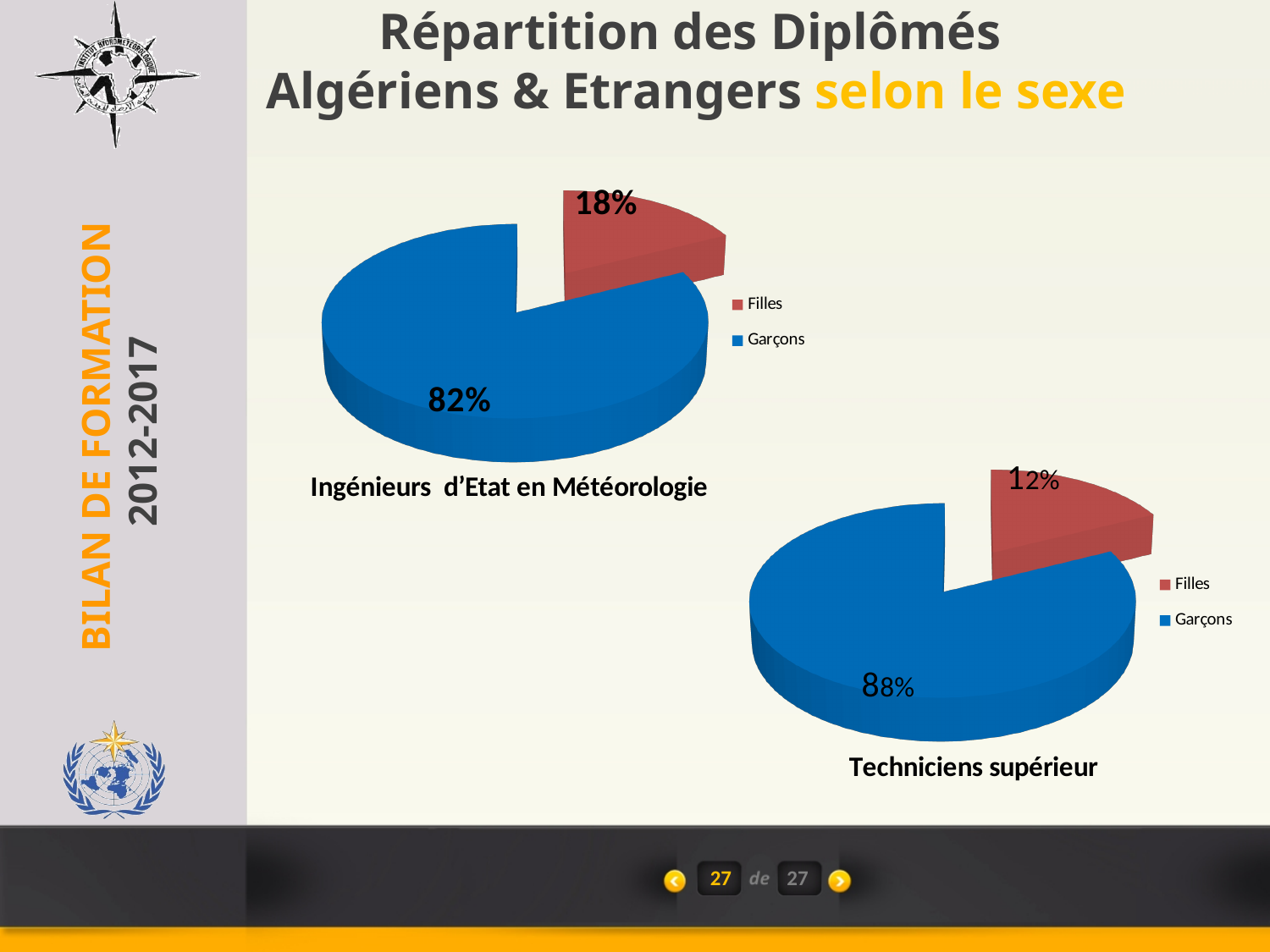
In the 'Techniciens supérieur' chart, what colour is the Garçons slice? Blue In the 'Techniciens supérieur' chart, what share of the pie is Garçons? 88% In the 'Techniciens supérieur' chart, what is the difference between the Garçons and Filles shares? 76% What kind of chart is the 'Techniciens supérieur' chart? Pie chart In the 'Techniciens supérieur' chart, which category has the smallest slice? Filles In the 'Techniciens supérieur' chart, what share of the pie is Filles? 12% In the 'Ingénieurs d'Etat en Météorologie' chart, which category has the largest slice? Garçons How many categories does the legend of the 'Ingénieurs d'Etat en Météorologie' chart list? 2 In the 'Ingénieurs d'Etat en Météorologie' chart, what is the difference between the Garçons and Filles shares? 64% In the 'Ingénieurs d'Etat en Météorologie' chart, what share of the pie is Filles? 18% Is the Filles share larger in the 'Ingénieurs d'Etat en Météorologie' chart or in the 'Techniciens supérieur' chart? Ingénieurs d'Etat en Météorologie In the 'Ingénieurs d'Etat en Météorologie' chart, what share of the pie is Garçons? 82%